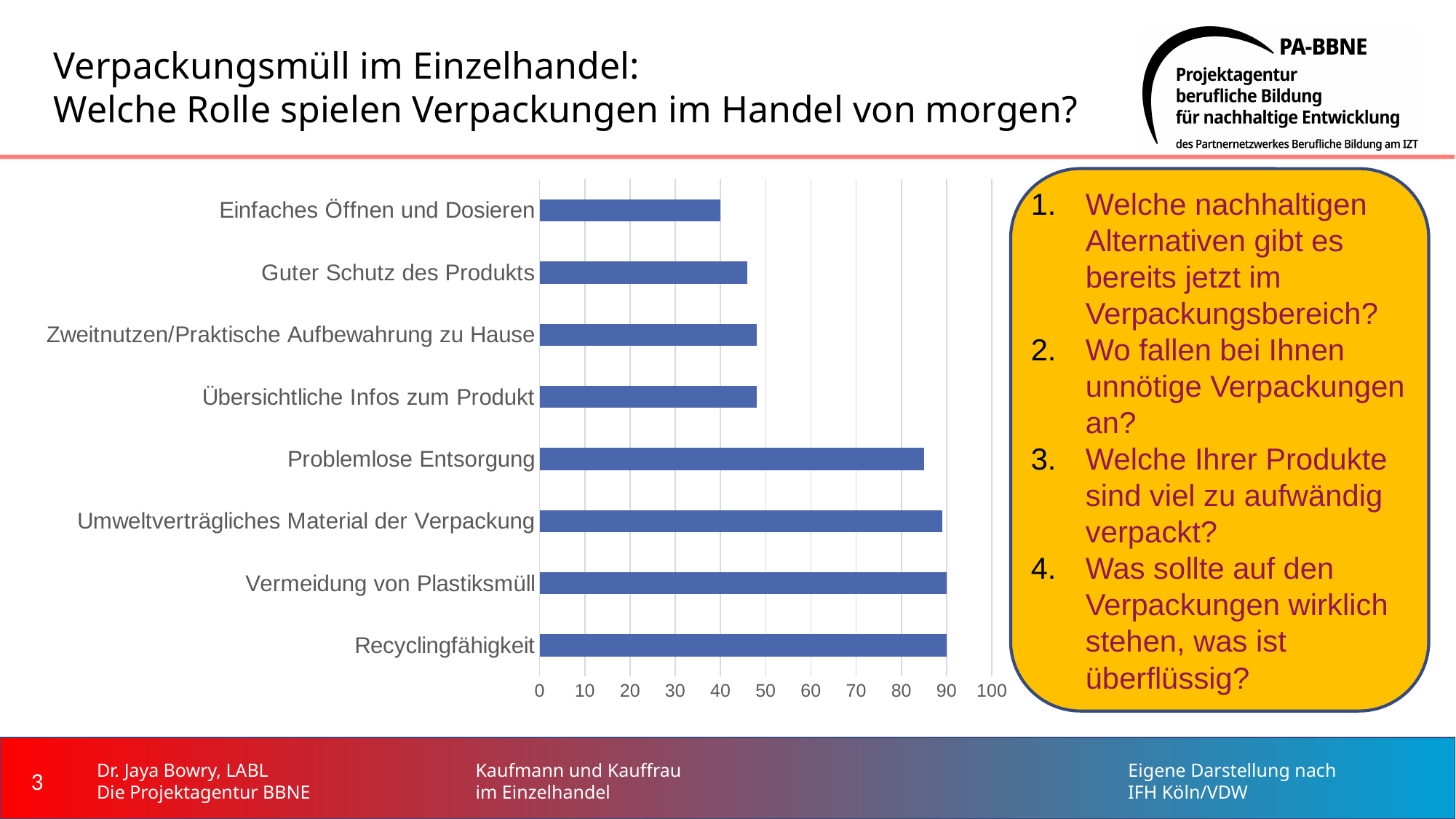
Is the value for Zweitnutzen/Praktische Aufbewahrung zu Hause greater or less than 50? less Which category has the lowest value in the bar chart? Einfaches Öffnen und Dosieren What is the value for Einfaches Öffnen und Dosieren? 40 Which is larger: the value for Problemlose Entsorgung or the value for Guter Schutz des Produkts? Problemlose Entsorgung How many categories are plotted in the bar chart? 8 Is the value for Guter Schutz des Produkts greater or less than 50? less Is the value for Recyclingfähigkeit greater or less than 80? greater What is the highest tick value shown on the horizontal axis of the chart? 100 What kind of chart is shown on the slide? bar chart Which is larger: the value for Übersichtliche Infos zum Produkt or the value for Vermeidung von Plastiksmüll? Vermeidung von Plastiksmüll